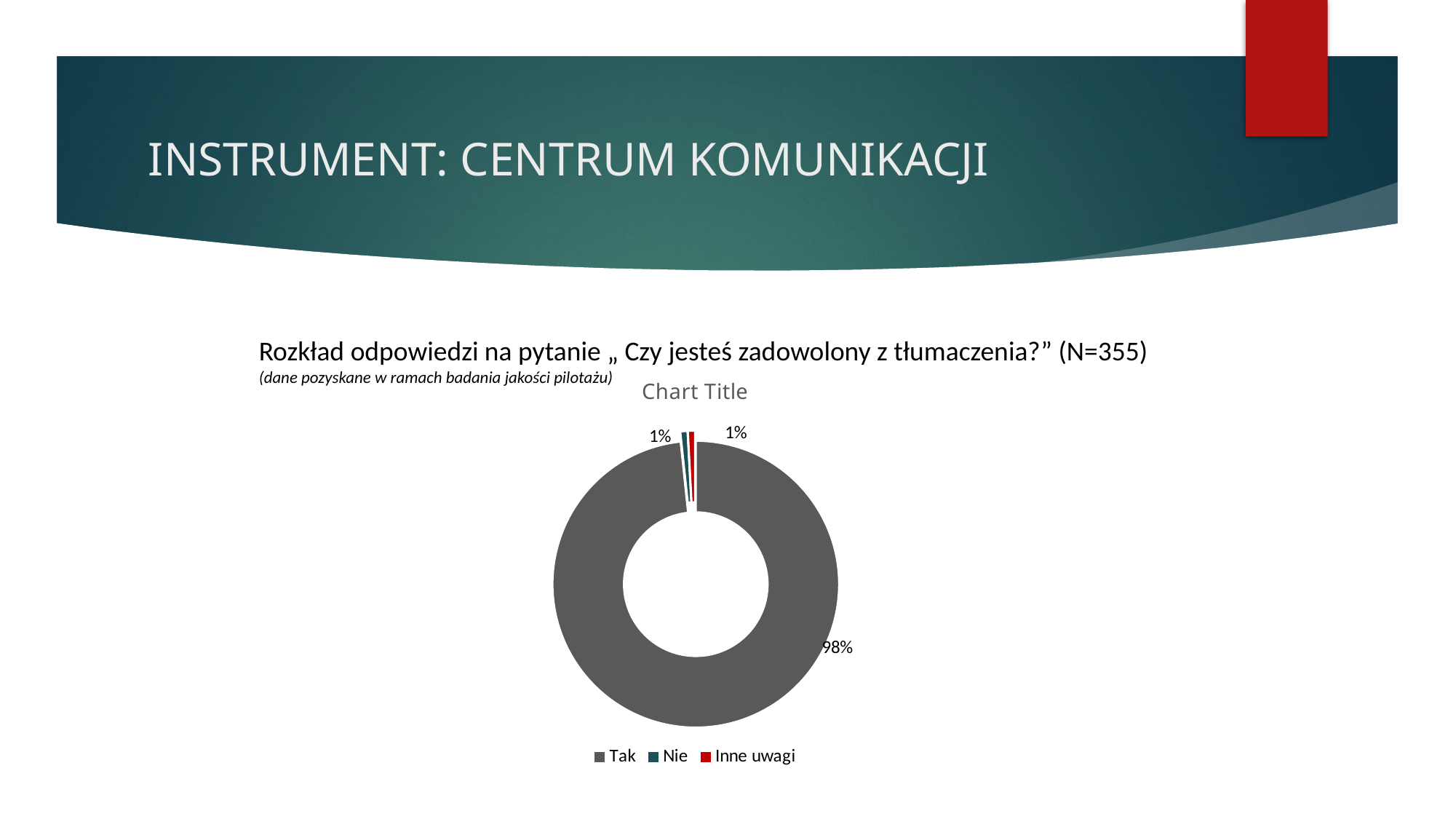
What percentage of respondents answered "Tak"? 98% How many answer categories are shown in the chart? 3 What is the difference in percentage points between "Tak" and "Nie"? 97 percentage points What percentage of respondents answered "Nie"? 1% Which is larger, the share for "Tak" or the share for "Inne uwagi"? Tak What title is displayed directly above the chart? Chart Title What percentage is shown for "Inne uwagi"? 1% What colour is the "Inne uwagi" slice in the legend? Red How many entries does the chart legend list? 3 Which answer category has the largest share of the chart? Tak What share of the chart does the "Tak" slice take up? 98% What kind of chart is shown on the slide? Doughnut (pie) chart